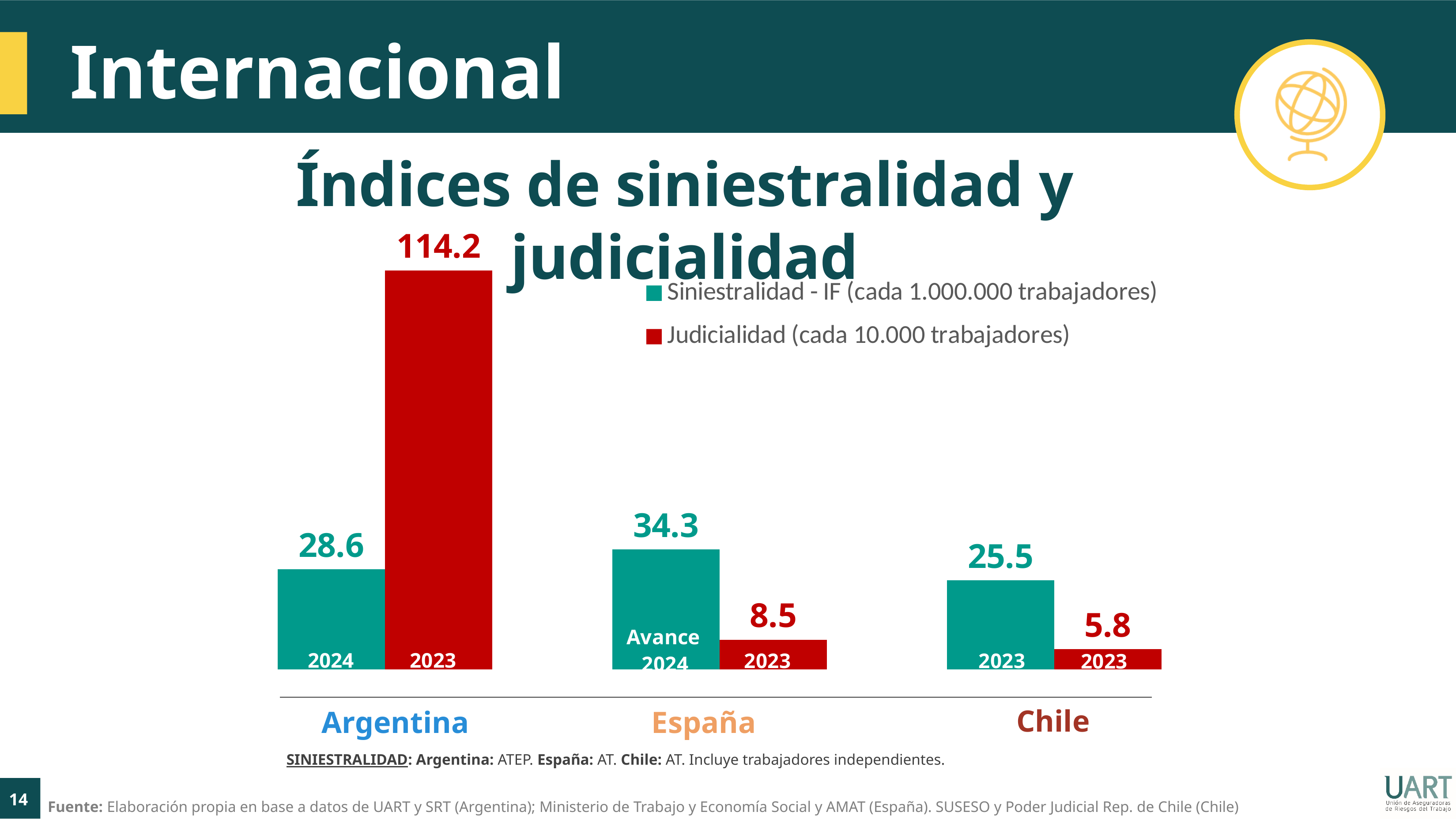
Which country has the highest Judicialidad value? Argentina What colour are the Judicialidad bars? Red Which is larger, the Siniestralidad - IF value for España or for Argentina? España What is the Siniestralidad - IF value for España? 34.3 Which country has the lowest Siniestralidad - IF value? Chile What is the Judicialidad value for Argentina? 114.2 How many series does the legend list? 2 What kind of chart is shown on the slide? Bar chart How many countries are shown on the x axis? 3 What is the Judicialidad value for Chile? 5.8 What is the difference between the Judicialidad values for España and Chile? 2.7 What is the Siniestralidad - IF value for Argentina? 28.6